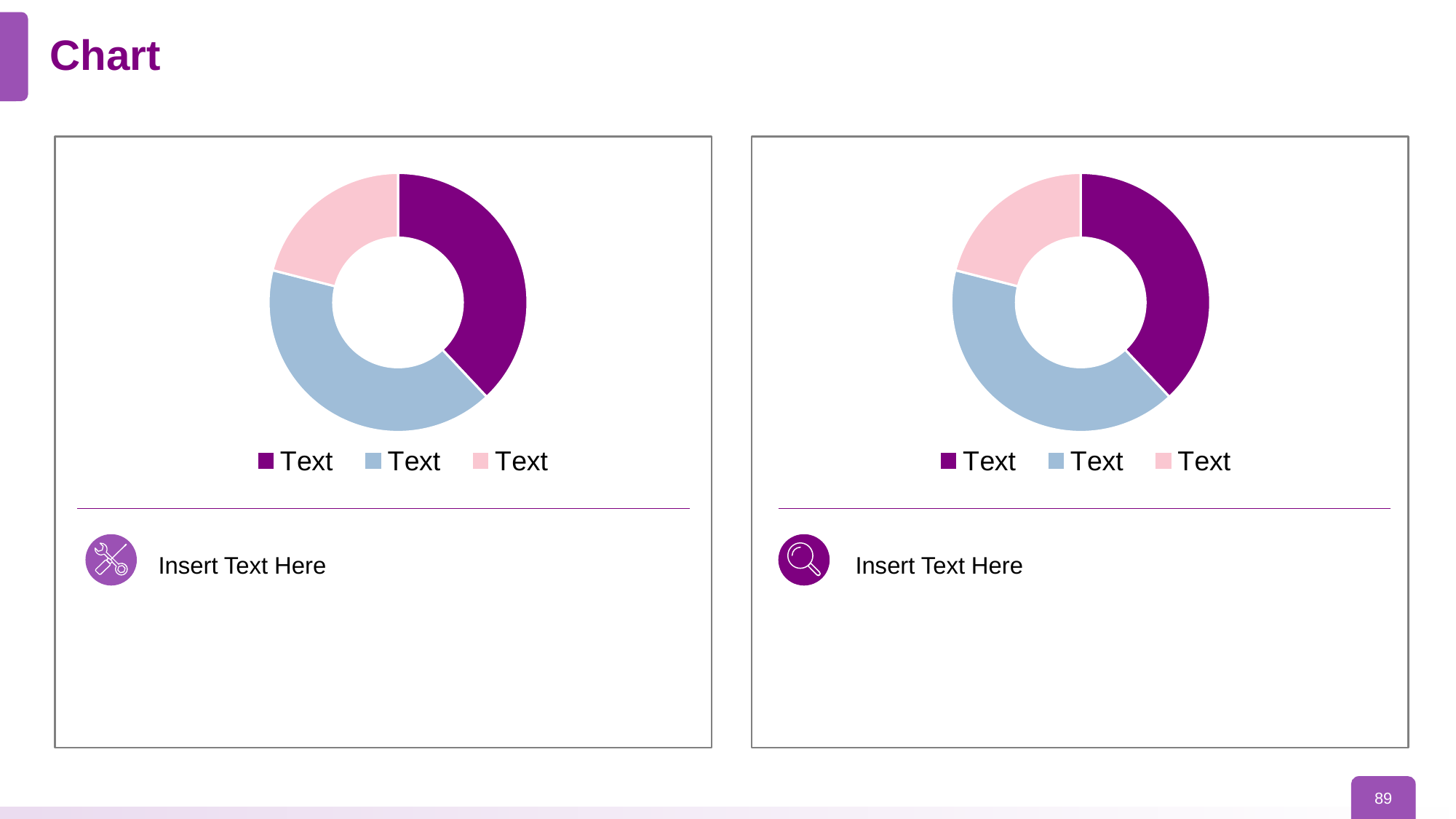
What kind of chart is the chart on the left side of the slide? doughnut chart How many entries does the legend of the left chart list? 3 In the chart on the right side of the slide, is the blue slice or the pink slice larger? blue In the chart on the left side of the slide, which colour slice is the smallest? pink In the chart on the right side of the slide, which colour slice is the smallest? pink In the chart on the left side of the slide, is the purple slice or the pink slice larger? purple How many slices does the chart on the right side of the slide have? 3 What is the title of the slide? Chart How many entries does the legend of the right chart list? 3 What label is given to each legend entry of the left chart? Text What kind of chart is the chart on the right side of the slide? doughnut chart How many slices does the chart on the left side of the slide have? 3